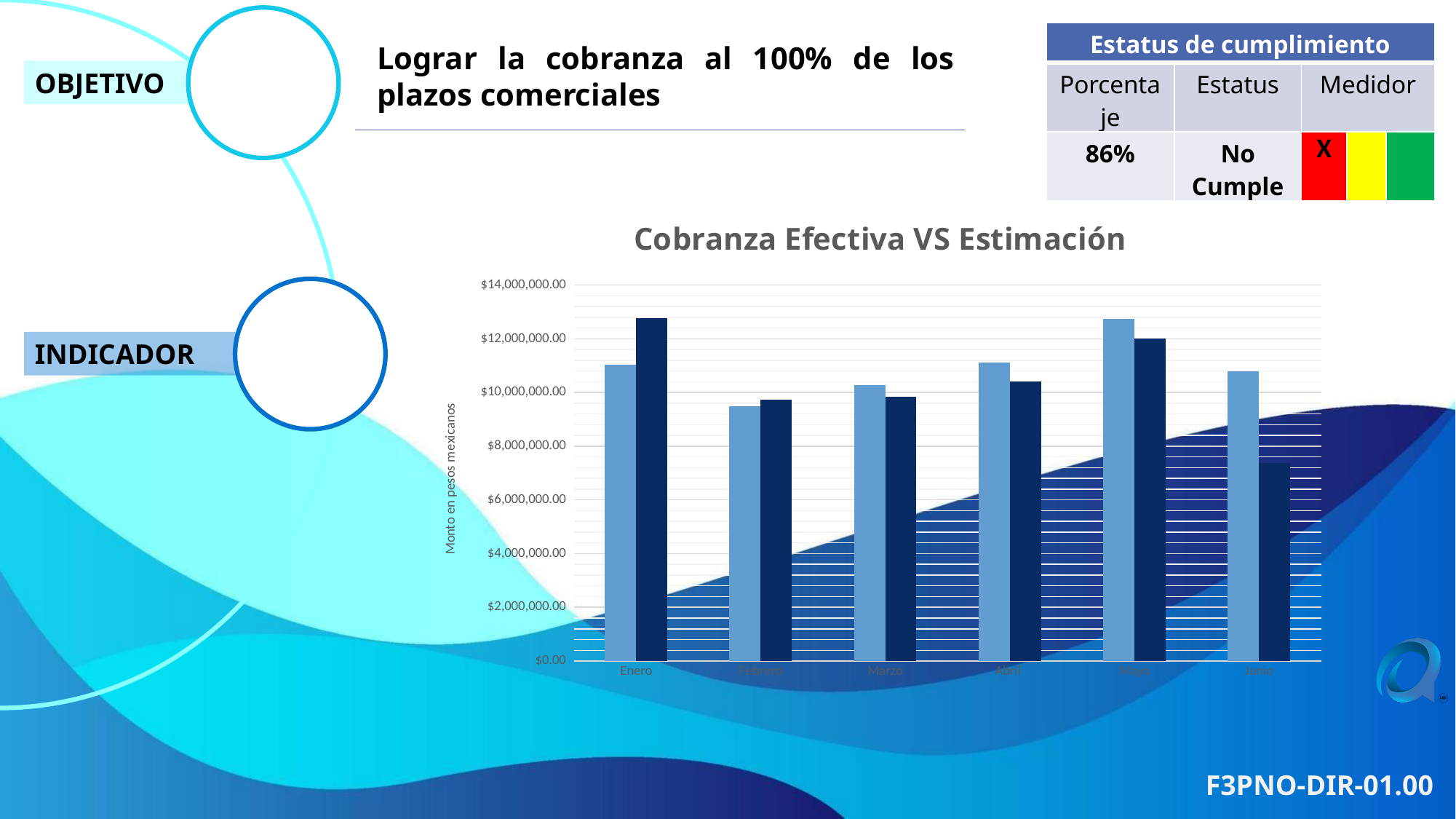
What is the title of the chart? Cobranza Efectiva VS Estimación For Enero, which bar is taller, the light blue bar or the dark blue bar? dark blue bar Which month has the shortest dark blue bar? Junio Is the light blue bar for Febrero greater or less than $10,000,000.00? less Is the dark blue bar for Junio greater or less than $8,000,000.00? less What is the label of the vertical axis of the chart? Monto en pesos mexicanos Is the dark blue bar for Enero greater or less than $12,000,000.00? greater How many months are shown on the x axis of the chart? 6 What kind of chart is shown on the slide? bar chart Which month has the tallest light blue bar? Mayo Which month has the shortest light blue bar? Febrero For Junio, which bar is taller, the light blue bar or the dark blue bar? light blue bar